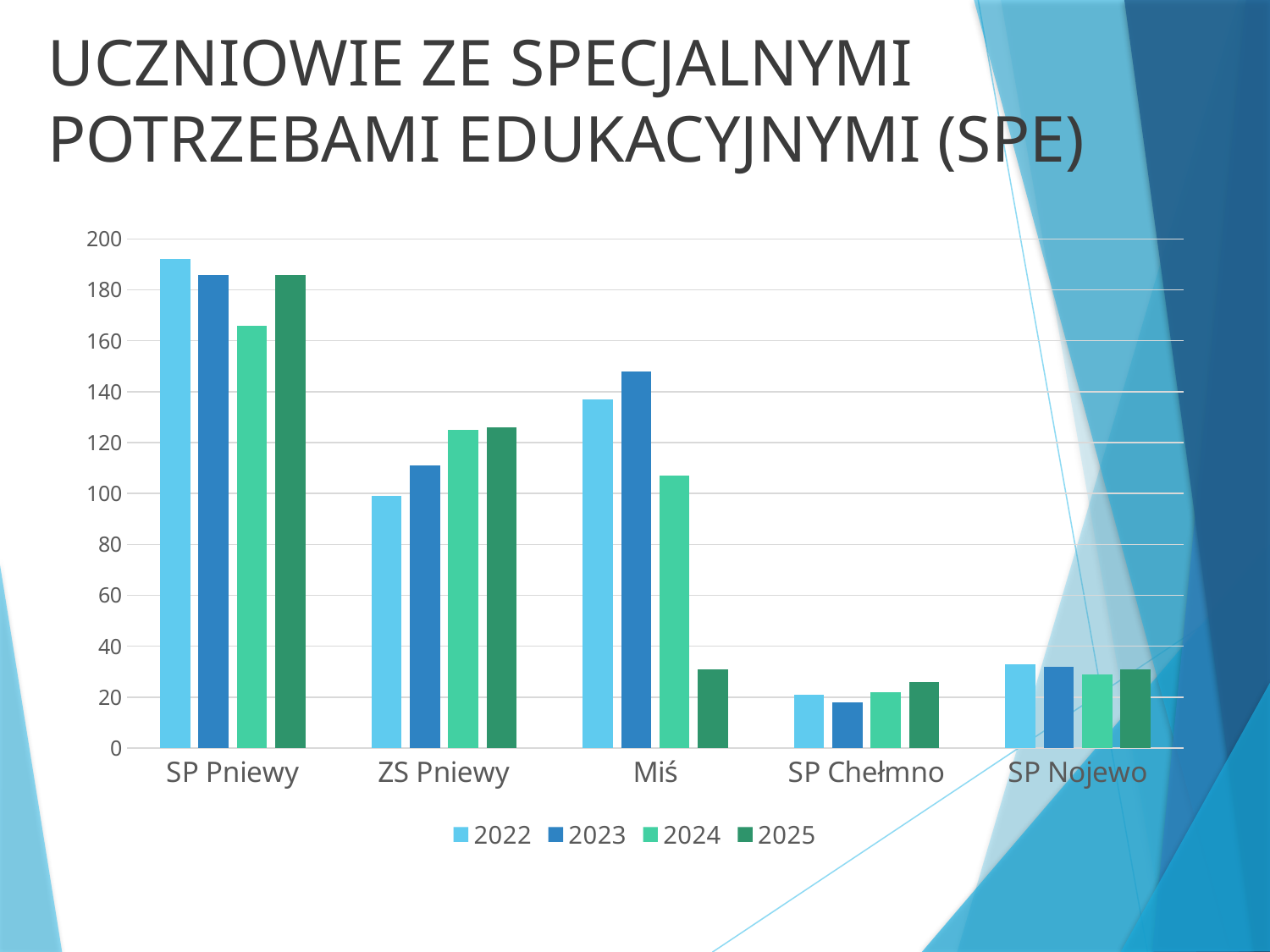
Is the value for SP Pniewy in 2022 greater or less than 180? greater What is the title of the slide containing the chart? UCZNIOWIE ZE SPECJALNYMI POTRZEBAMI EDUKACYJNYMI (SPE) Is the value for Miś in 2025 greater or less than 40? less Do the values for ZS Pniewy rise or fall from 2022 to 2025? rise Which school has the lowest value for 2022? SP Chełmno What kind of chart is shown on the slide? bar chart Is the value for Miś in 2023 greater or less than 140? greater How many schools (categories) are shown on the x axis? 5 Which is larger for 2023: the value for Miś or the value for ZS Pniewy? Miś Which school has the highest value for 2022? SP Pniewy How many series does the legend list? 4